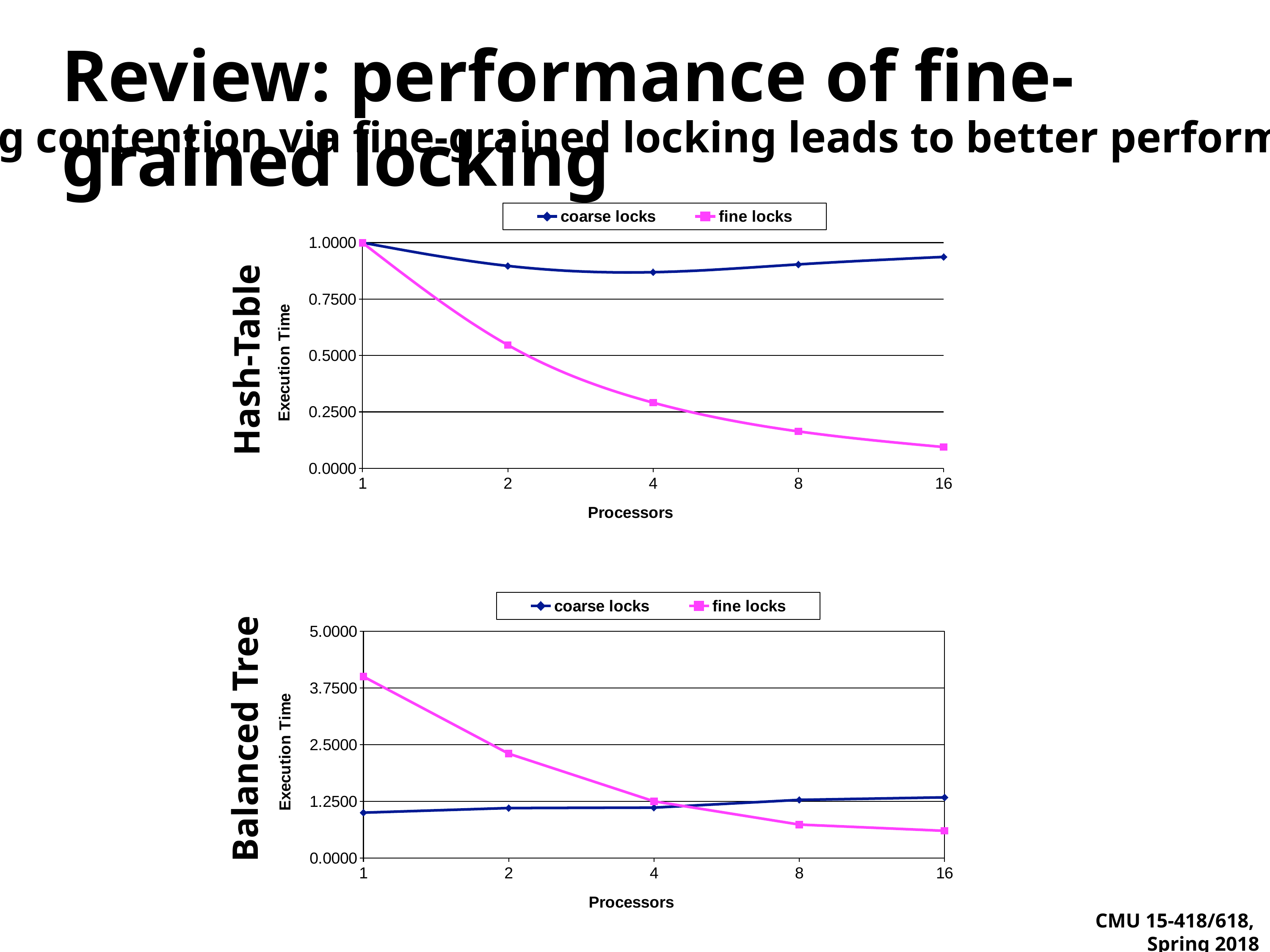
How many processor counts are plotted along the x axis of the Hash-Table chart? 5 In the Balanced Tree chart, which series has the larger value at 16 processors, coarse locks or fine locks? coarse locks In the Balanced Tree chart, is the fine locks value at 1 processor greater or less than 3.7500? greater In the Hash-Table chart, is the coarse locks value at 16 processors greater or less than 0.7500? greater In the Hash-Table chart, do the fine locks values rise or fall as the number of processors increases? fall What kind of chart is the Hash-Table chart? line chart In the Balanced Tree chart, which series has the larger value at 2 processors, coarse locks or fine locks? fine locks How many series does the legend of the Balanced Tree chart list? 2 In the Hash-Table chart, which series has the larger value at 8 processors, coarse locks or fine locks? coarse locks In the Hash-Table chart, what is the execution time for coarse locks at 1 processor? 1.0000 In the Hash-Table chart, at which processor count is the fine locks value lowest? 16 In the Hash-Table chart, is the fine locks value at 4 processors greater or less than 0.5000? less